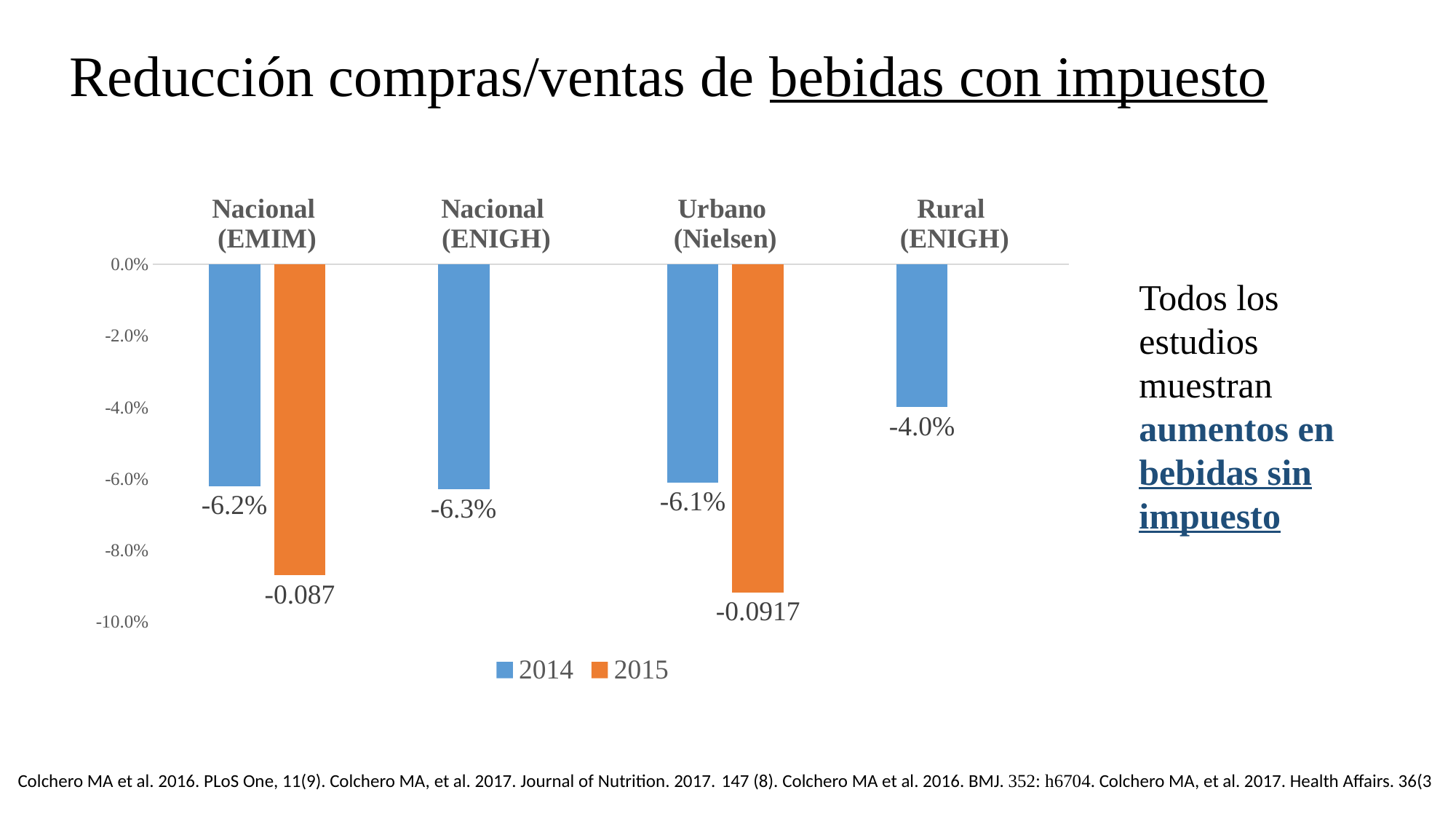
What is the 2014 value for Urbano (Nielsen)? -6.1% How many series does the legend list? 2 Which category has the lowest (most negative) 2015 value? Urbano (Nielsen) What is the difference between the 2014 values for Nacional (EMIM) and Rural (ENIGH)? 2.2 percentage points What is the 2014 value for Nacional (EMIM)? -6.2% How many categories are shown on the x axis? 4 Which category has the highest (least negative) 2014 value? Rural (ENIGH) What is the 2014 value for Nacional (ENIGH)? -6.3% What is the 2015 value for Urbano (Nielsen)? -0.0917 What is the 2015 value for Nacional (EMIM)? -0.087 Is the 2015 value for Urbano (Nielsen) greater or less than -8.0%? less What is the 2014 value for Rural (ENIGH)? -4.0%